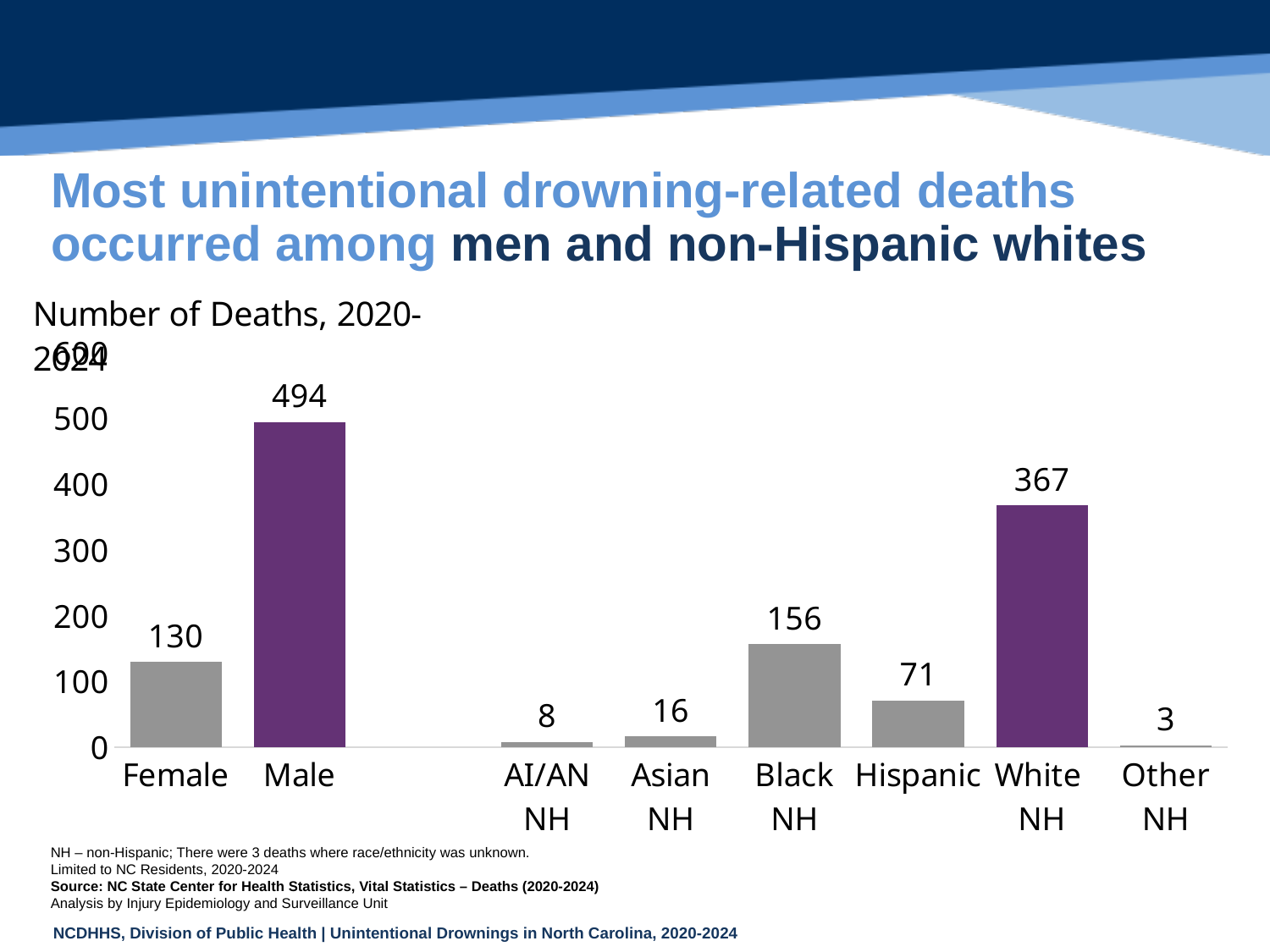
What is the difference in deaths between White NH and Black NH? 211 Which category has the highest number of deaths? Male What is the number of deaths for Asian NH? 16 What is the number of deaths for Male? 494 What type of chart is shown on the slide? Bar chart What is the number of deaths for Female? 130 Which category has the lowest number of deaths? Other NH What is the number of deaths for Hispanic? 71 What is the difference in deaths between Male and Female? 364 What is the number of deaths for Black NH? 156 Which has more deaths, Hispanic or Asian NH? Hispanic How many categories are shown on the x axis? 8